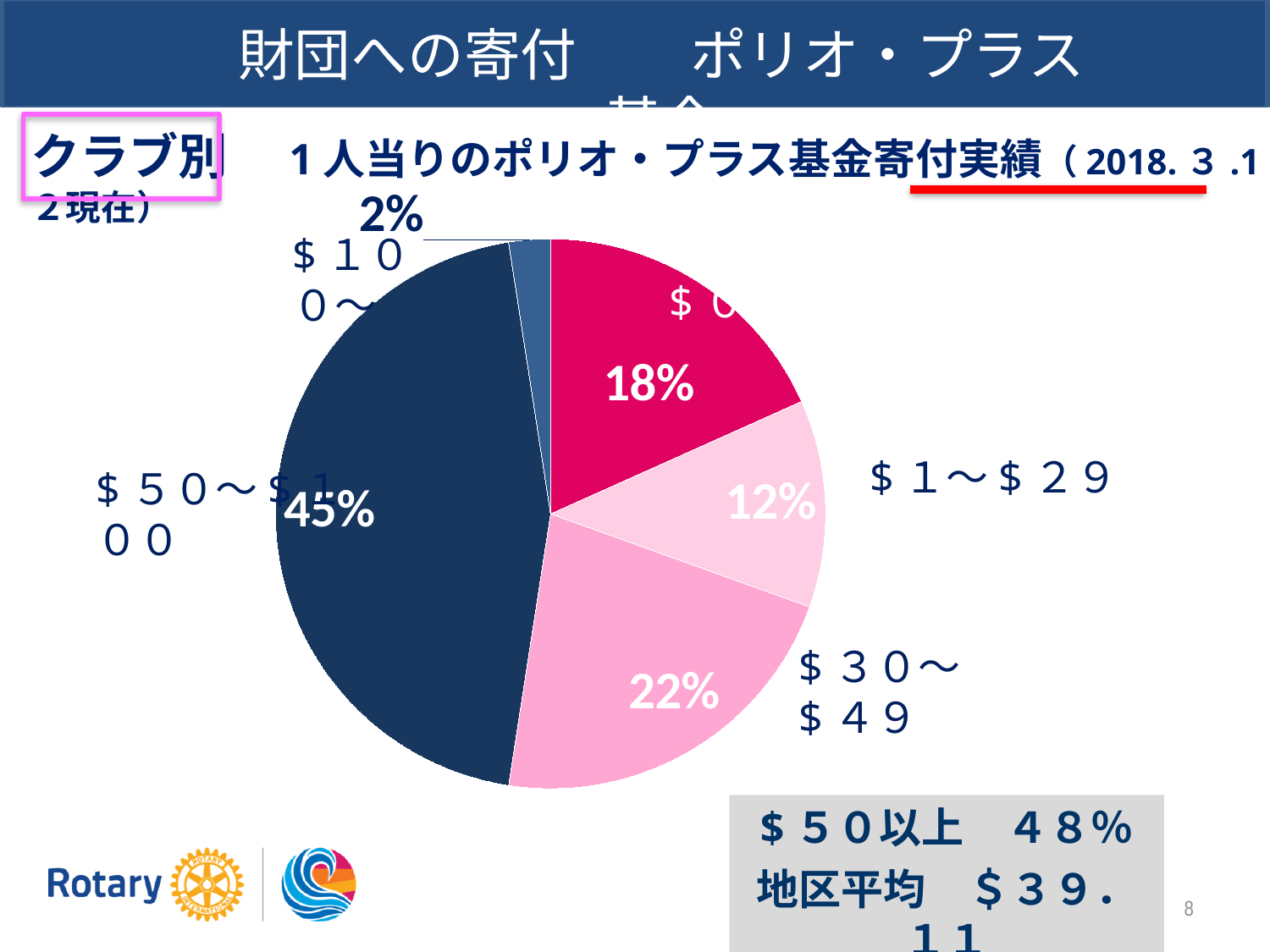
What percentage of the pie is the $５０～$１００ slice? 45% How many slices does the pie chart have? 5 What is the difference in percentage points between the $５０～$１００ slice and the $３０～$４９ slice? 23 Which category has the smallest share of the pie? $１００～ What percentage of the pie is the $３０～$４９ slice? 22% What percentage of the pie is the $０ slice? 18% Which category has the largest share of the pie? $５０～$１００ What kind of chart is shown on the slide? pie chart What date is given in the chart title for the data? 2018.3.12 Which slice is larger, $０ or $１～$２９? $０